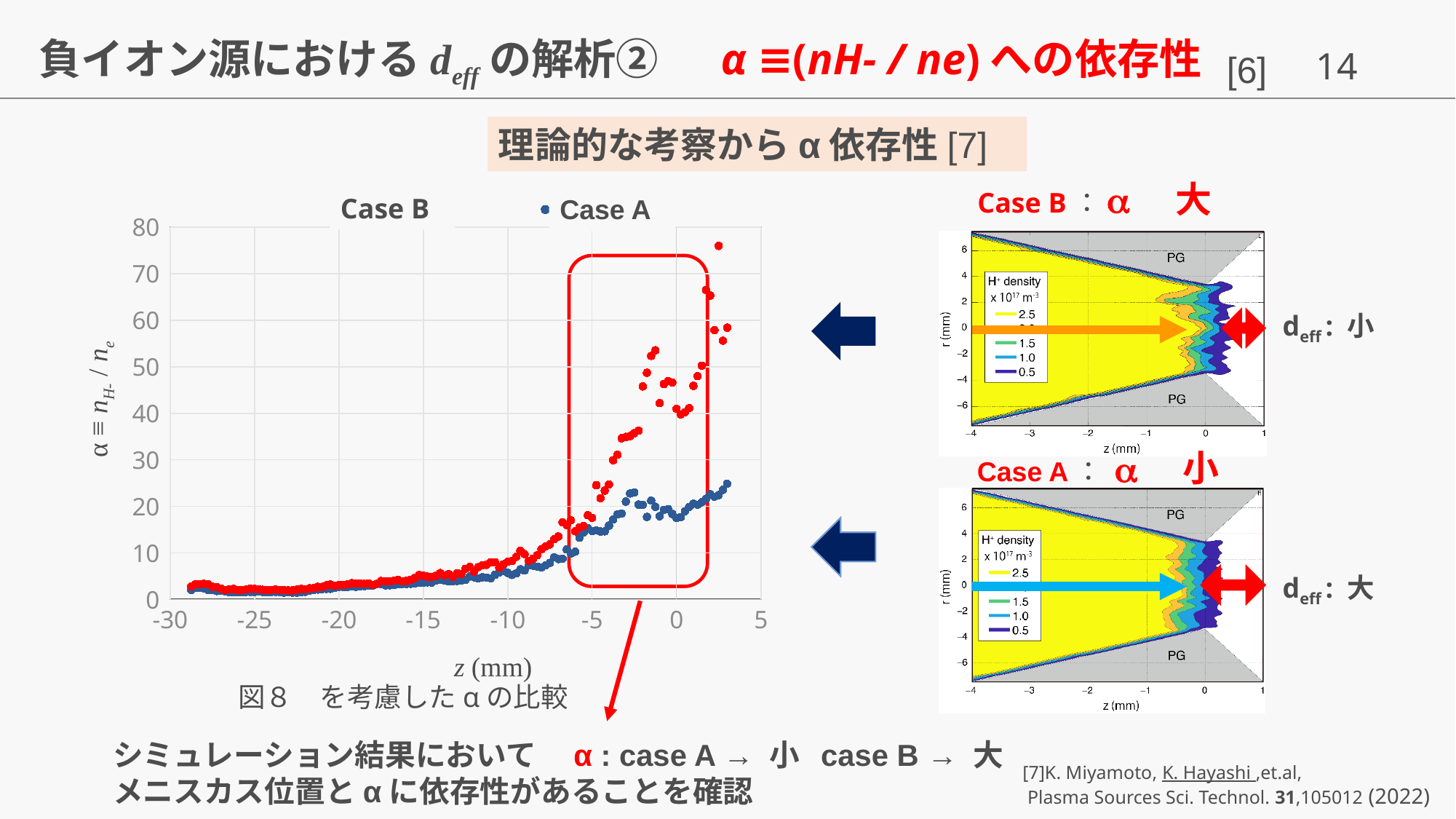
In the scatter chart on the left, which series is plotted in red? Case B In the two contour plots on the right, what quantity is shown according to their legends? H+ density In the scatter chart on the left, at z = -25 mm, is the value for Case A greater or less than 10? less In the scatter chart on the left, how many series does the legend list? 2 In the scatter chart on the left, do the values of Case B generally rise or fall as z increases from -30 to 5 mm? rise In the scatter chart on the left, what is the label of the x axis? z (mm) In the scatter chart on the left, which series reaches the highest α value? Case B In the scatter chart on the left, is the highest Case A value greater or less than 30? less In the scatter chart on the left, near z = 0 mm, which series has the larger α values, Case A or Case B? Case B In the scatter chart on the left, is the highest Case B value greater or less than 70? greater In the scatter chart on the left, what kind of chart is it? scatter chart